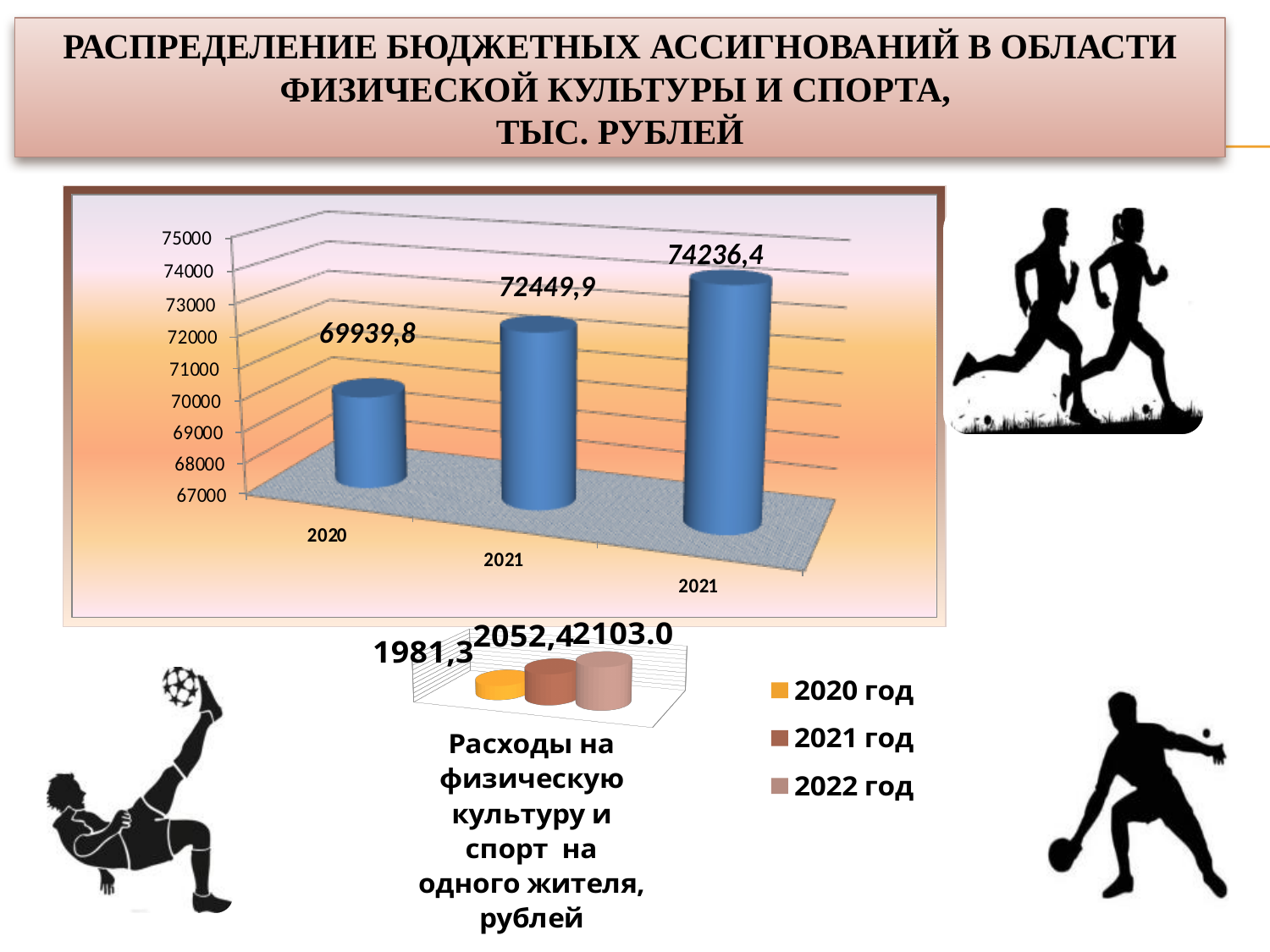
How many entries does the legend of the bottom chart list? 3 In the bottom chart (Расходы на физическую культуру и спорт на одного жителя, рублей), what is the value for 2020 год? 1981,3 In the top chart, what is the value of the middle bar? 72449,9 In the top chart, what is the value of the rightmost bar? 74236,4 In the bottom chart (Расходы на физическую культуру и спорт на одного жителя, рублей), what is the value for 2022 год? 2103.0 In the top chart, what is the difference between the rightmost bar and the 2020 bar? 4296,6 What kind of chart is the top chart? bar chart In the top chart, how many bars are plotted? 3 In the top chart, is the value for 2020 greater or less than 70000? less In the top chart, which bar is the lowest? 2020 In the top chart, do the values rise or fall from left to right? rise In the top chart, what is the value of the bar for 2020? 69939,8